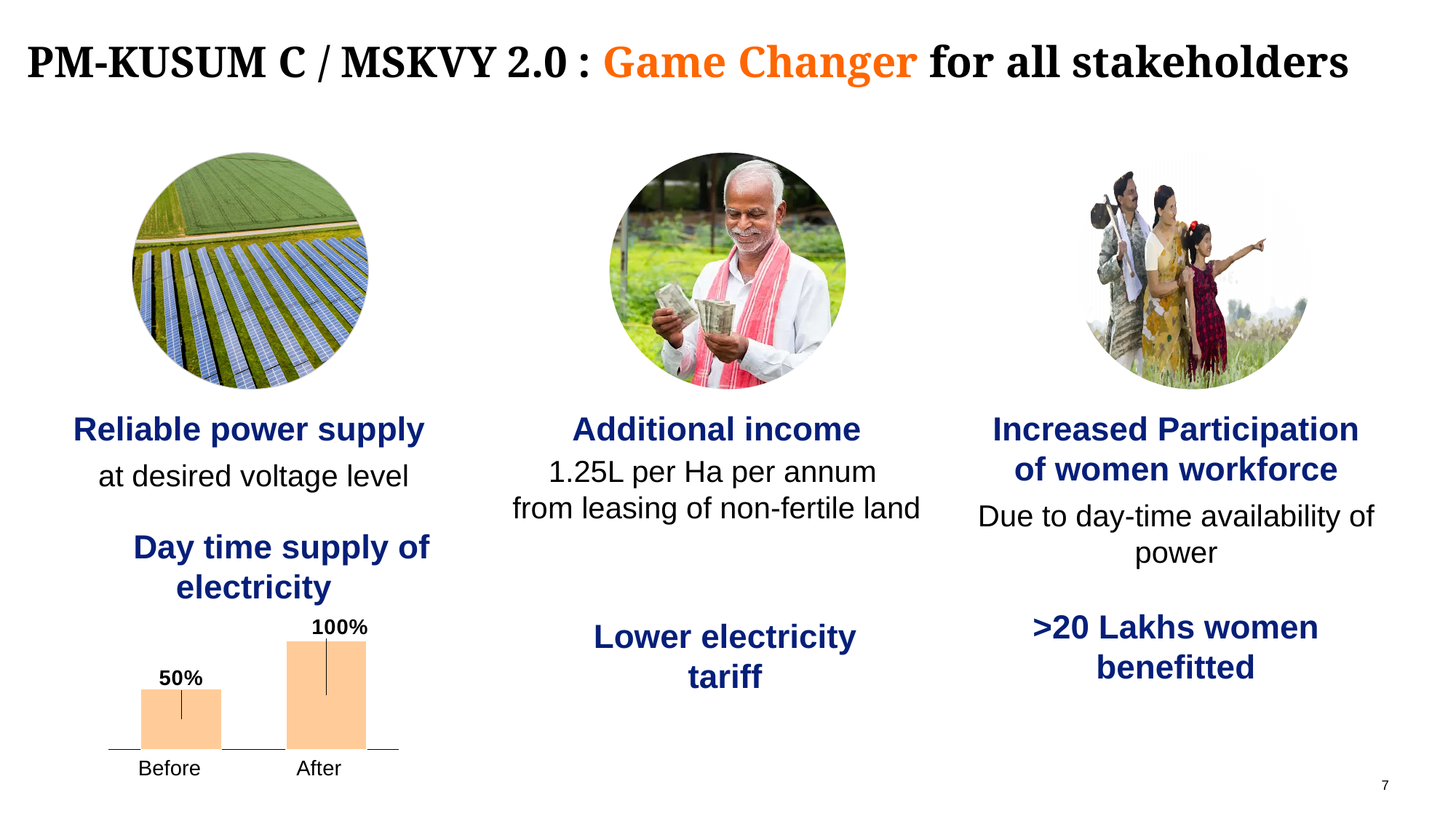
Which category has the highest value in the Day time supply of electricity chart? After What is the value for Before in the Day time supply of electricity chart? 50% What is the value for After in the Day time supply of electricity chart? 100% What is the difference between the After and Before values in the Day time supply of electricity chart? 50% Do the values rise or fall from Before to After in the Day time supply of electricity chart? rise What is the title of the chart on the slide? Day time supply of electricity Which category has the lowest value in the Day time supply of electricity chart? Before What colour are the bars in the Day time supply of electricity chart? orange What kind of chart is the Day time supply of electricity chart? bar chart In the Day time supply of electricity chart, is the value for Before or After larger? After How many categories are shown in the Day time supply of electricity chart? 2